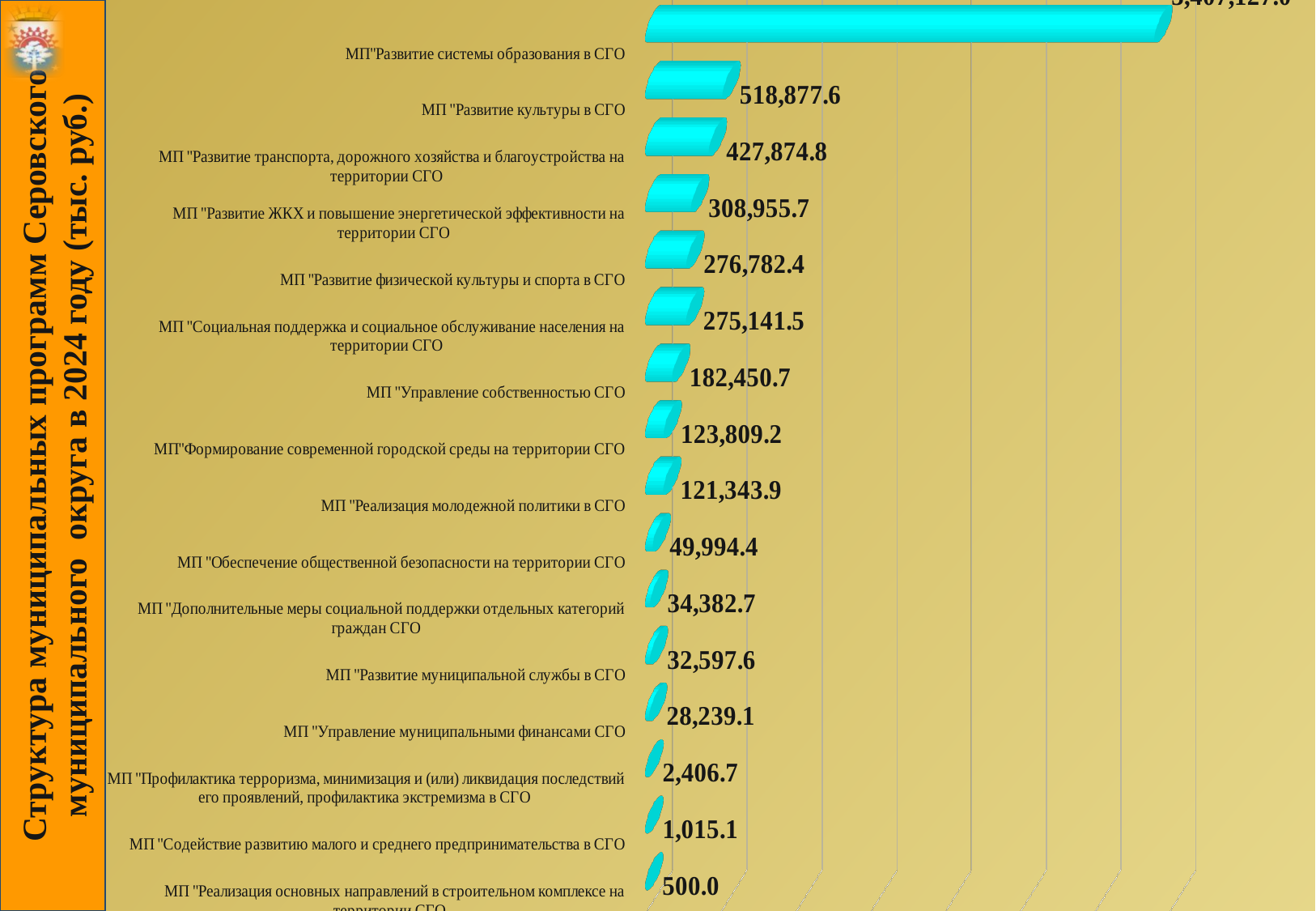
Which program has the highest value? МП "Развитие системы образования в СГО" What kind of chart is shown on the slide? Bar chart What is the title of the chart? Структура муниципальных программ Серовского муниципального округа в 2024 году (тыс. руб.) What is the value for МП "Развитие культуры в СГО"? 518,877.6 What is the value for МП "Реализация основных направлений в строительном комплексе на территории СГО"? 500.0 What is the value for МП "Развитие ЖКХ и повышение энергетической эффективности на территории СГО"? 308,955.7 How many programs (categories) are shown in the chart? 16 What is the difference between the values for МП "Развитие физической культуры и спорта в СГО" and МП "Социальная поддержка и социальное обслуживание населения на территории СГО"? 1,640.9 Which is larger: the value for МП "Обеспечение общественной безопасности на территории СГО" or МП "Дополнительные меры социальной поддержки отдельных категорий граждан СГО"? МП "Обеспечение общественной безопасности на территории СГО" What is the value for МП "Управление собственностью СГО"? 182,450.7 What is the difference between the values for МП "Развитие культуры в СГО" and МП "Развитие транспорта, дорожного хозяйства и благоустройства на территории СГО"? 91,002.8 Which program has the lowest value? МП "Реализация основных направлений в строительном комплексе на территории СГО"